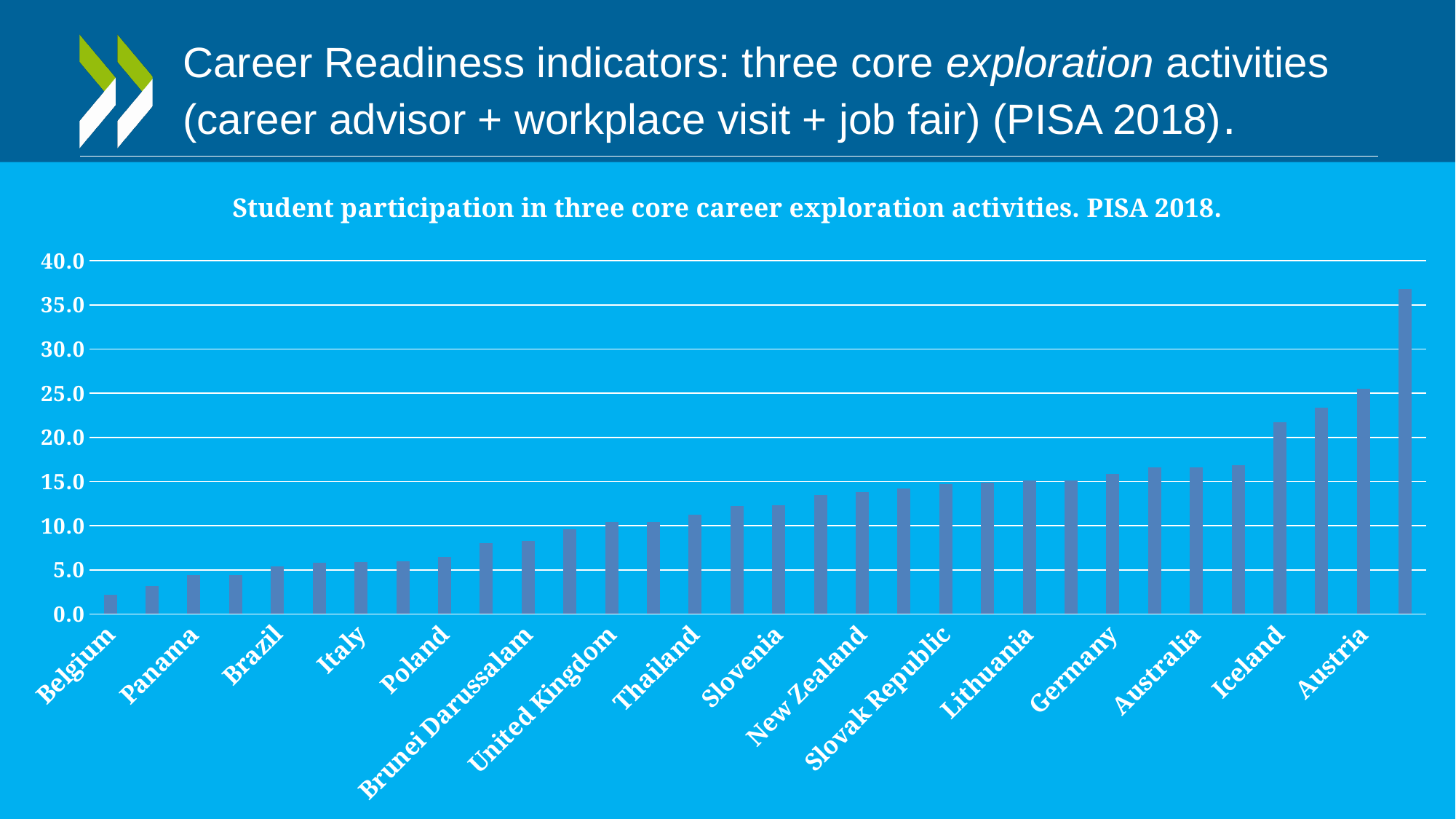
Which has the larger value, Belgium or Austria? Austria Which has the larger value, Panama or Germany? Germany Do the bar values rise or fall from left to right along the x axis? rise What is the title of the chart? Student participation in three core career exploration activities. PISA 2018. Is the value for Germany greater or less than 10.0? greater Is the value for Panama greater or less than 5.0? less Is the value for Belgium greater or less than 5.0? less Which labelled country has the lowest value? Belgium What kind of chart is shown on the slide? bar chart